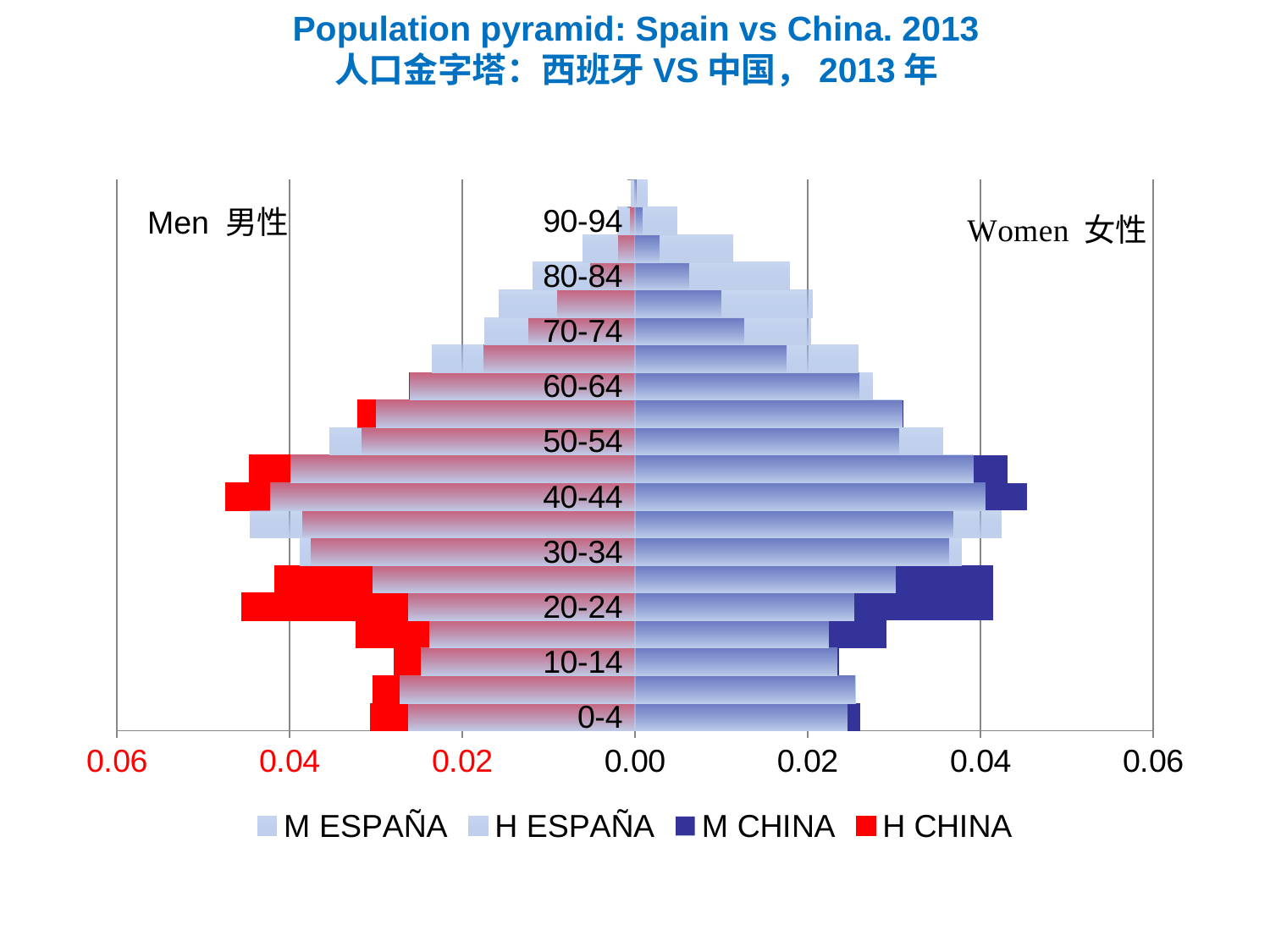
What is the title of the chart? Population pyramid: Spain vs China. 2013 Which colour represents the H CHINA series in the legend? Red Is the value for men (H ESPAÑA) in the 60-64 age group greater or less than 0.02? greater Is the value for men (H CHINA) in the 0-4 age group greater or less than 0.02? greater Is the value for women (M ESPAÑA) in the 90-94 age group greater or less than 0.02? less What kind of chart is shown on the slide? Bar chart How many series does the legend list? 4